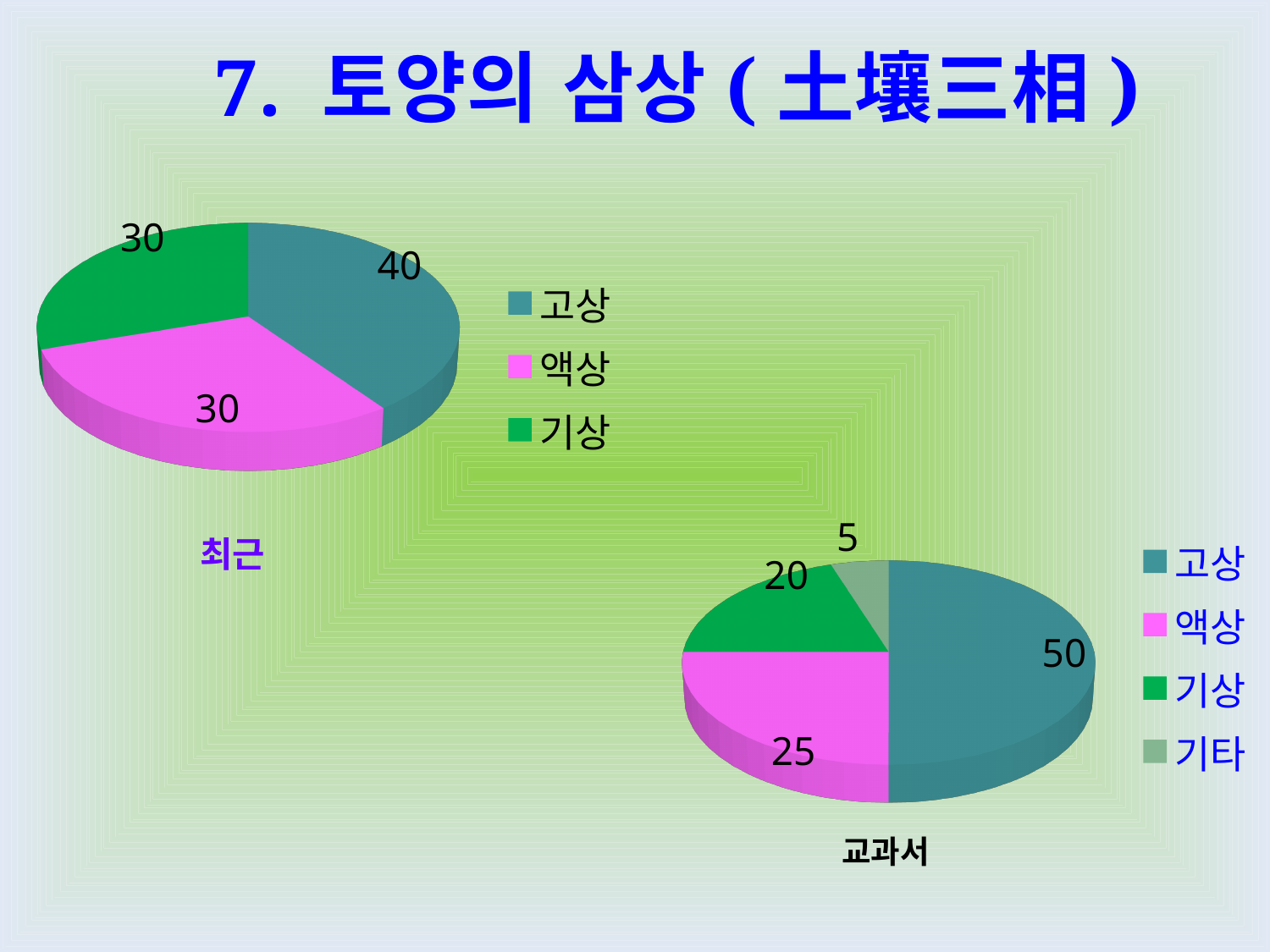
In the bottom-right pie chart labelled 교과서, what is the difference between the values for 고상 and 액상? 25 In the bottom-right pie chart labelled 교과서, which is larger, 액상 or 기상? 액상 How many entries does the legend of the top-left pie chart labelled 최근 list? 3 In the bottom-right pie chart labelled 교과서, which category has the smallest slice? 기타 In the bottom-right pie chart labelled 교과서, what is the value for 고상? 50 In the top-left pie chart labelled 최근, which category has the largest slice? 고상 In the bottom-right pie chart labelled 교과서, what is the value for 기타? 5 In the top-left pie chart labelled 최근, what is the value for 액상? 30 How many slices does the bottom-right pie chart labelled 교과서 have? 4 In the bottom-right pie chart labelled 교과서, which category has the largest slice? 고상 What type of chart is used for the 최근 data on the slide? Pie chart In the top-left pie chart labelled 최근, what is the value for 고상? 40